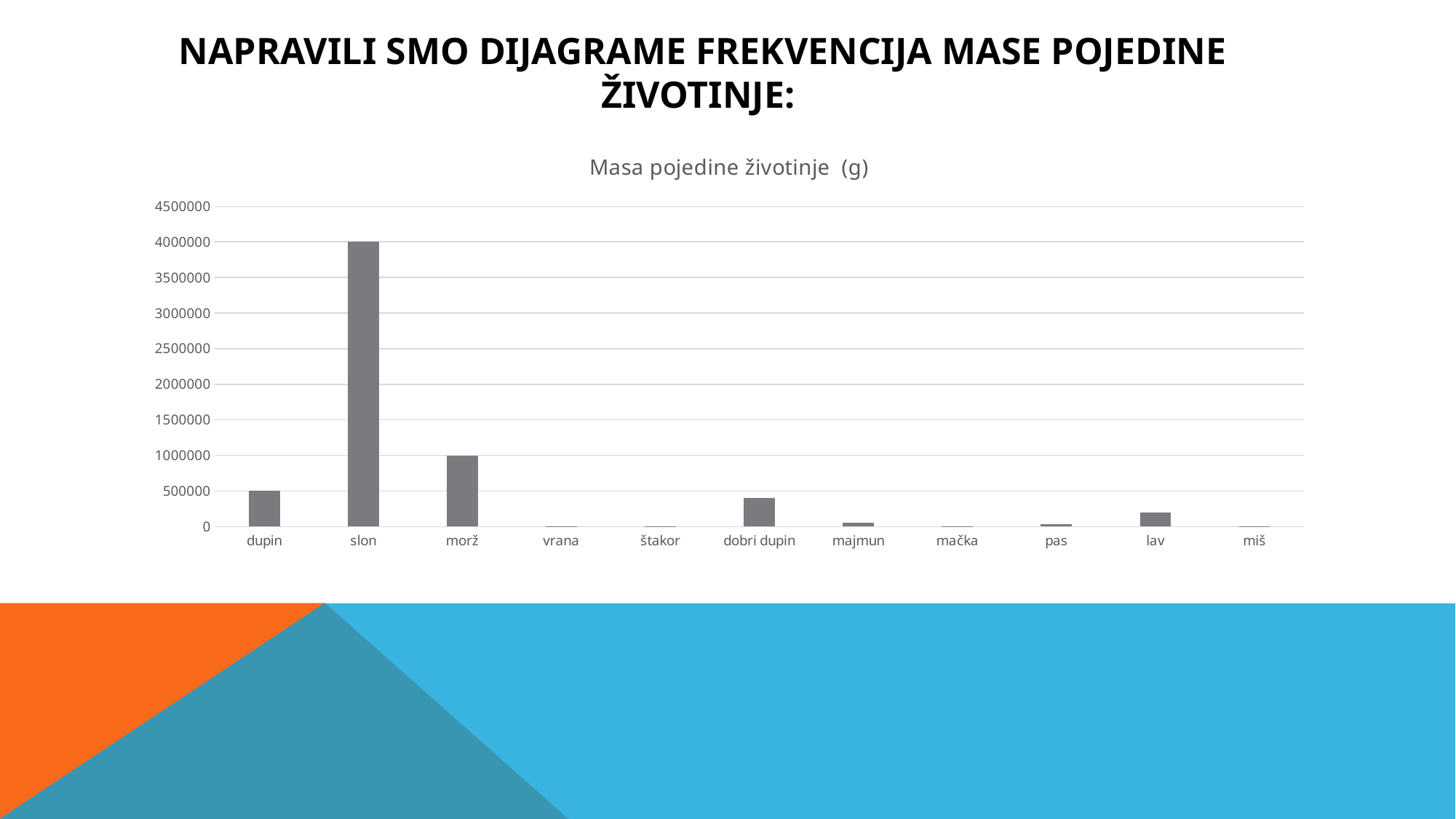
How many animal categories are shown on the x axis? 11 Is the value for slon greater or less than 3500000? greater Is the value for lav greater or less than 500000? less Which animal has the highest mass in the chart? slon Is the value for dobri dupin greater or less than 500000? less What is the mass value shown for slon? 4000000 What is the title of the chart? Masa pojedine životinje (g) What kind of chart is shown on the slide? bar chart Which has a larger value, morž or slon? slon What is the mass value shown for morž? 1000000 Which has a larger value, dupin or dobri dupin? dupin Which has a larger value, lav or majmun? lav